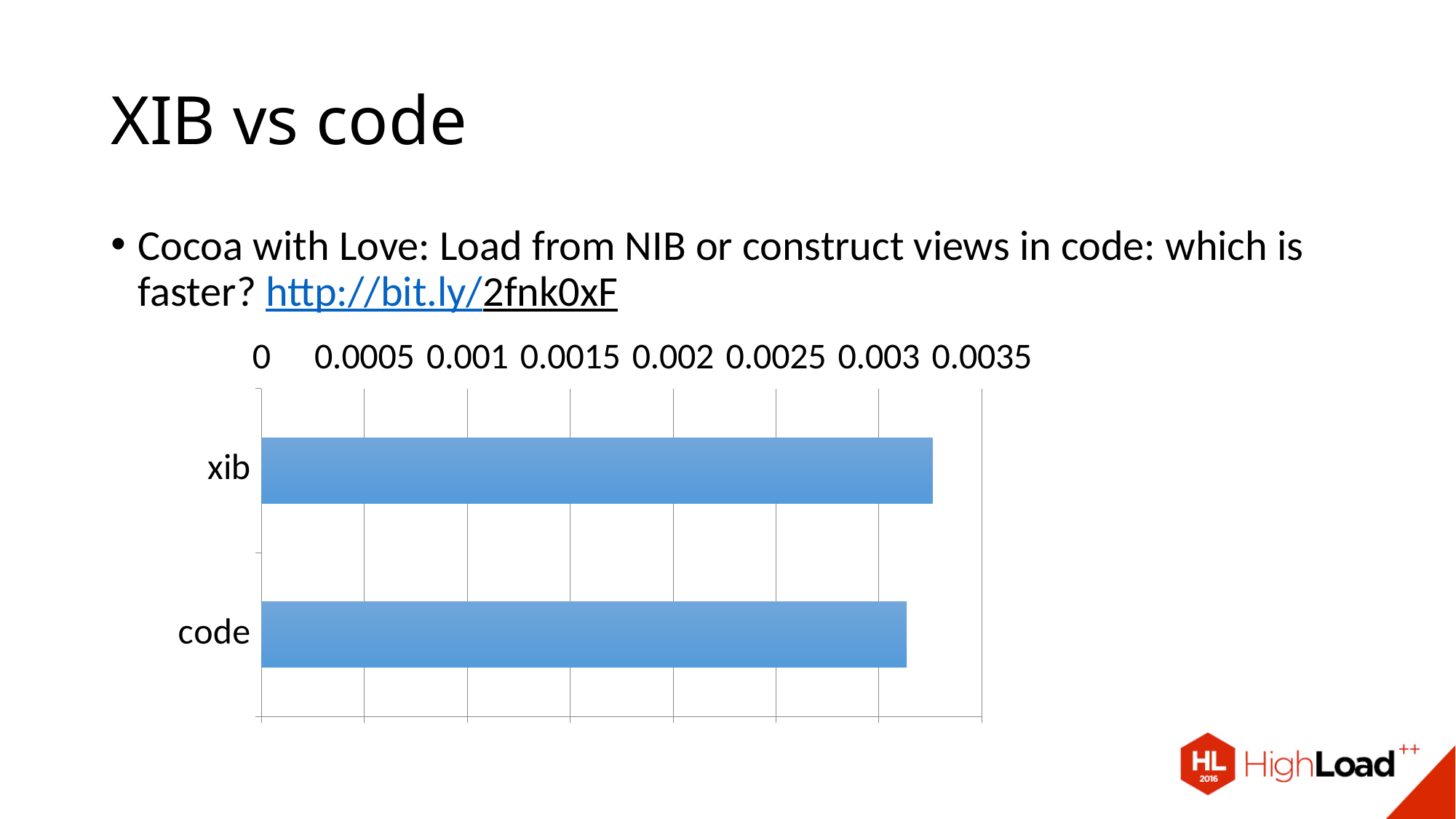
Which has the larger value, xib or code? xib What are the two category labels shown on the chart's vertical axis? xib and code How many categories are plotted in the chart? 2 What is the largest tick value shown on the chart's horizontal axis? 0.0035 Which category has the highest value in the chart? xib Is the value for code greater or less than 0.003? greater Is the value for code greater or less than 0.0035? less Is the value for code greater or less than 0.002? greater What kind of chart is shown on the slide? bar chart Which category has the lowest value in the chart? code